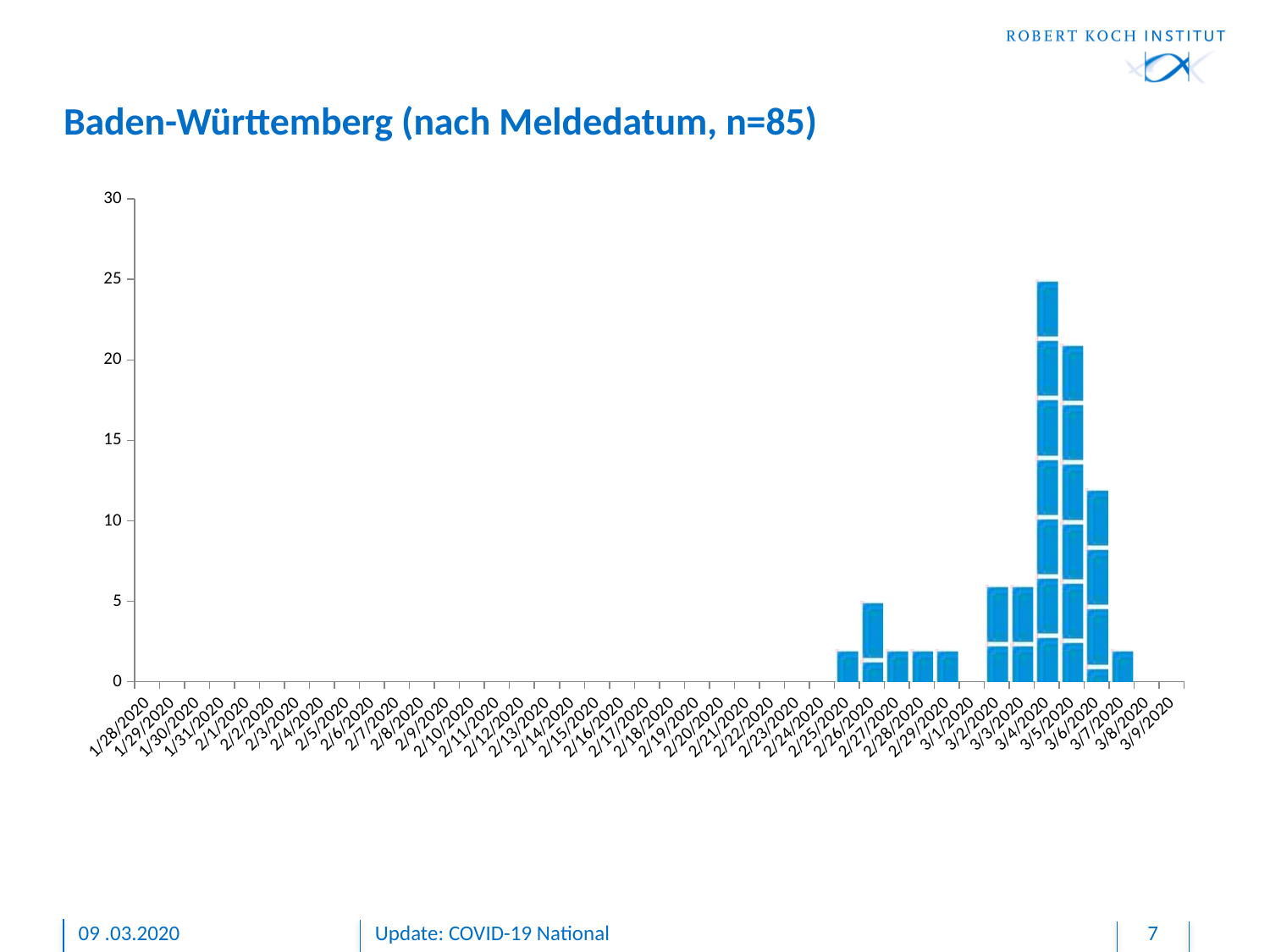
How many dates are shown on the x axis? 42 Is the value for 3/6/2020 greater or less than 10? greater Is the value for 3/5/2020 greater or less than 15? greater Is the value for 3/4/2020 greater or less than 20? greater What kind of chart is shown on the slide? bar chart Which date has the highest bar? 3/4/2020 What is the title of the chart? Baden-Württemberg (nach Meldedatum, n=85) Do the values rise or fall from 3/4/2020 to 3/7/2020? fall Which is larger, the value for 3/6/2020 or the value for 3/7/2020? 3/6/2020 Which is larger, the value for 3/4/2020 or the value for 3/5/2020? 3/4/2020